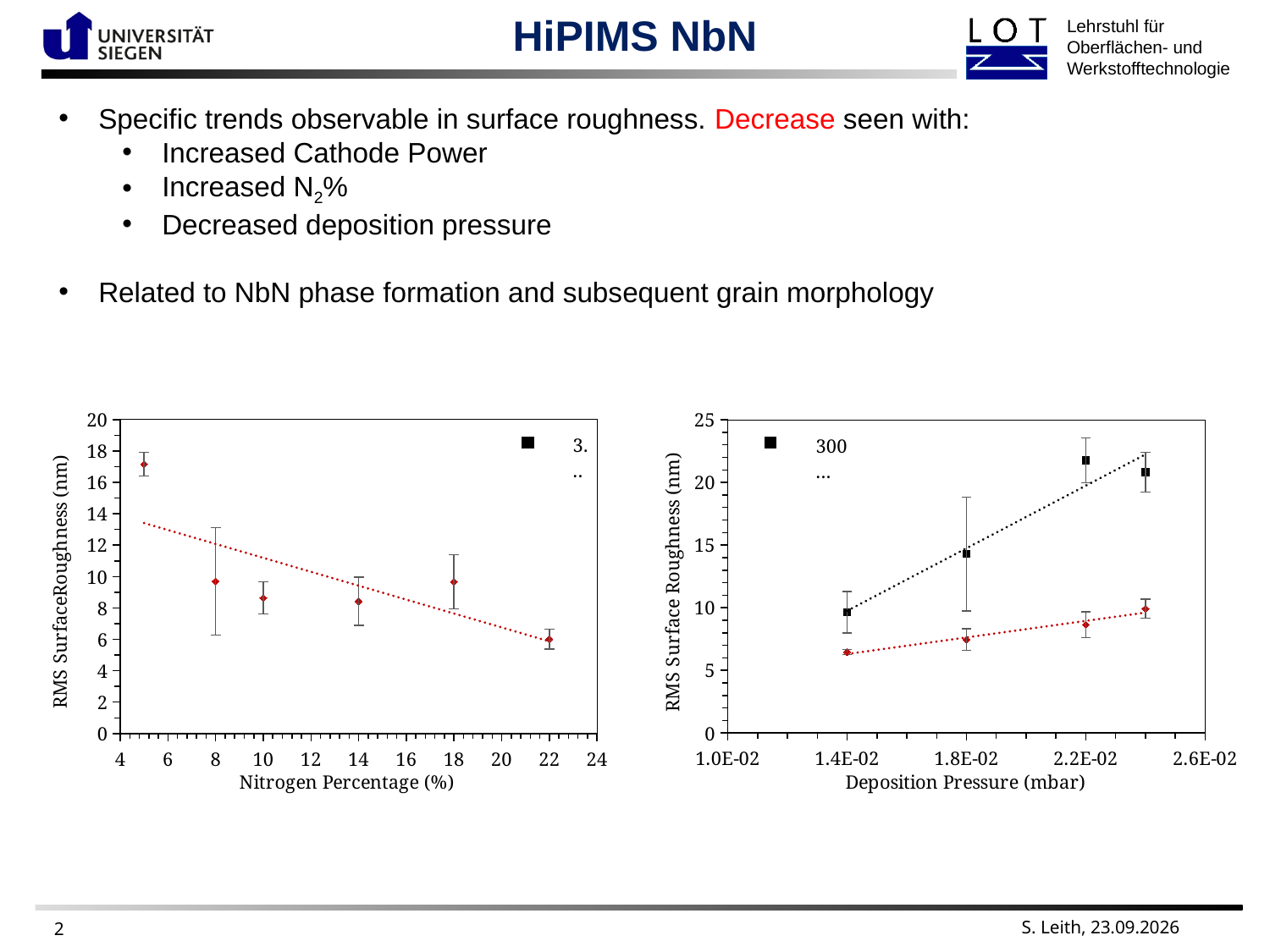
In the left chart, is the RMS surface roughness at 22% nitrogen greater or less than 8 nm? less How many data points are plotted in the left chart? 6 What is the x-axis title of the right chart? Deposition Pressure (mbar) In the right chart, at 1.8E-02 mbar, which series has the larger RMS surface roughness: the black squares or the red diamonds? black squares In the left chart, do the RMS surface roughness values generally rise or fall as nitrogen percentage increases? fall What kind of chart is the left chart (Nitrogen Percentage)? scatter chart In the left chart, is the RMS surface roughness at 5% nitrogen greater or less than 15 nm? greater In the right chart, is the black-square series value at 2.2E-02 mbar greater or less than 20 nm? greater In the left chart, at which nitrogen percentage is the RMS surface roughness lowest? 22 In the left chart, at which nitrogen percentage is the RMS surface roughness highest? 5 In the right chart, do the RMS surface roughness values generally rise or fall as deposition pressure increases? rise